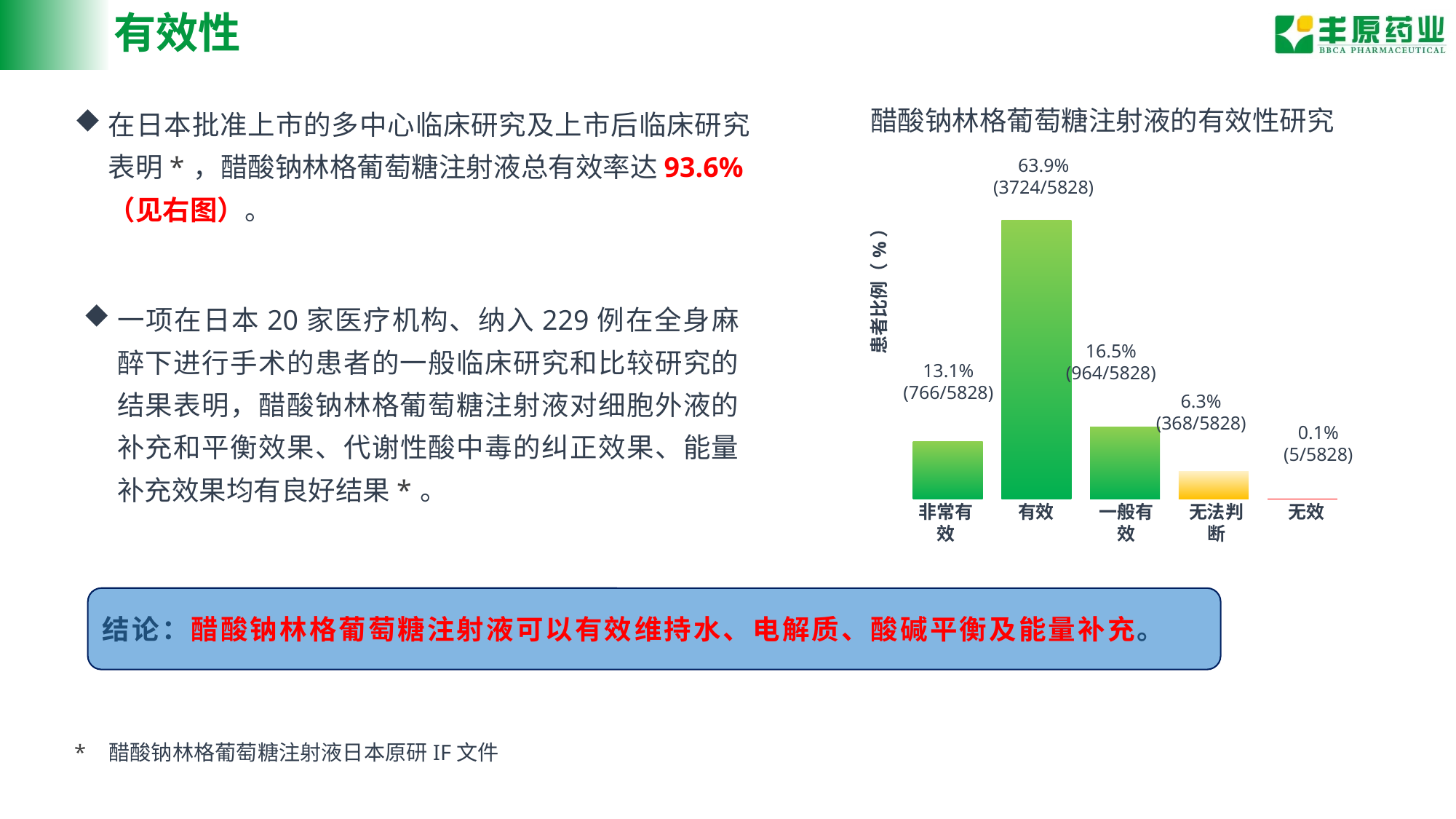
What is the title of the chart? 醋酸钠林格葡萄糖注射液的有效性研究 What is the percentage value for 非常有效? 13.1% What is the percentage value for 一般有效? 16.5% What type of chart is shown on the slide? bar chart Which is larger, the value for 一般有效 or the value for 非常有效? 一般有效 What is the percentage value for 有效? 63.9% What is the percentage value for 无法判断? 6.3% What is the percentage value for 无效? 0.1% What is the difference in percentage points between 有效 and 一般有效? 47.4 Which category has the lowest value? 无效 How many categories are plotted in the chart? 5 Which category has the highest value? 有效